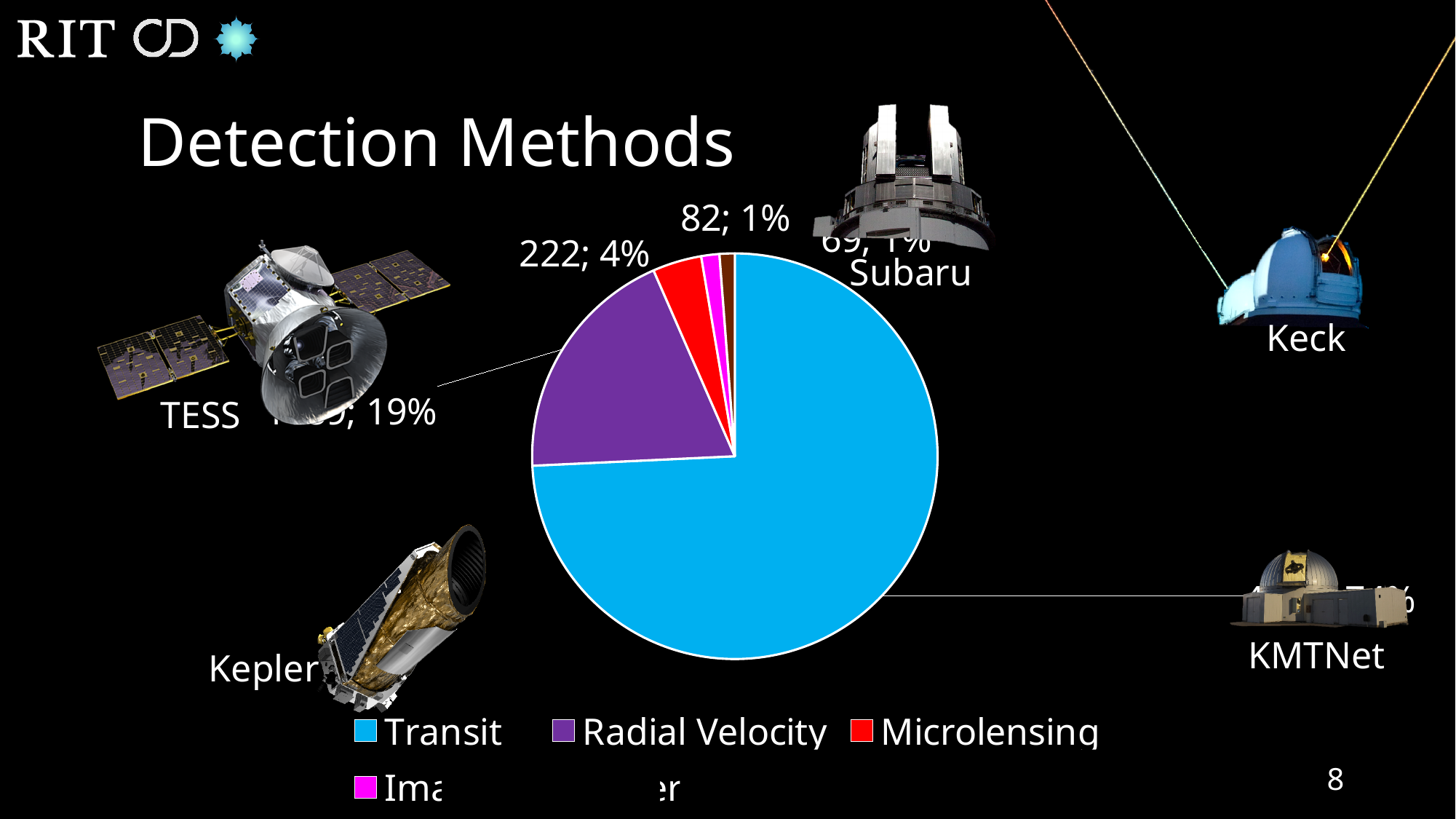
Which detection method has the largest slice of the pie? Transit What count is shown on the data label for Microlensing? 222 What percentage is shown on the data label for the slice with a count of 82? 1% Which is larger, the Radial Velocity slice or the Microlensing slice? Radial Velocity What percentage of the pie does Radial Velocity account for? 19% What colour is the Transit slice in the pie chart? blue Is the Transit share of the pie greater or less than 50%? greater How many slices does the pie chart have? 5 What percentage of the pie does Microlensing account for? 4% What is the difference between the Microlensing count (222) and the count of the slice labelled 82? 140 What is the title of the slide containing the pie chart? Detection Methods What kind of chart is shown on the slide? pie chart